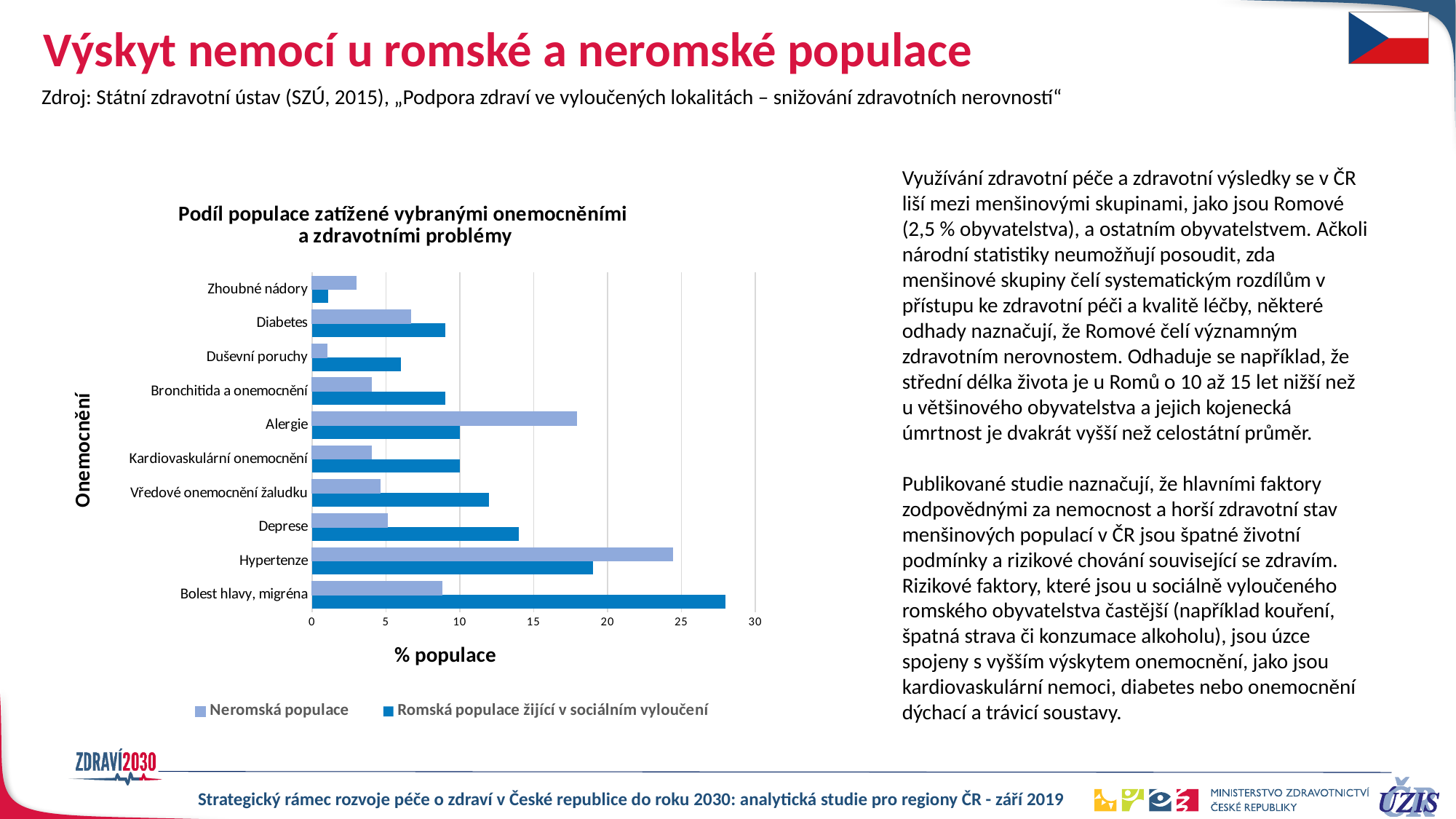
Which category has the highest value for the Neromská populace series? Hypertenze Is the value for Zhoubné nádory in the Neromská populace series greater or less than 5? less Is the value for Hypertenze in the Romská populace žijící v sociálním vyloučení series greater or less than 15? greater Which category has the lowest value for the Romská populace žijící v sociálním vyloučení series? Zhoubné nádory Is the value for Bolest hlavy, migréna in the Romská populace žijící v sociálním vyloučení series greater or less than 25? greater What kind of chart is shown on the slide? bar chart Which category has the highest value for the Romská populace žijící v sociálním vyloučení series? Bolest hlavy, migréna Which category has the lowest value for the Neromská populace series? Duševní poruchy What is the label of the x axis? % populace How many disease categories are plotted on the chart? 10 How many series does the legend list? 2 For Alergie, which series has the larger value: Neromská populace or Romská populace žijící v sociálním vyloučení? Neromská populace